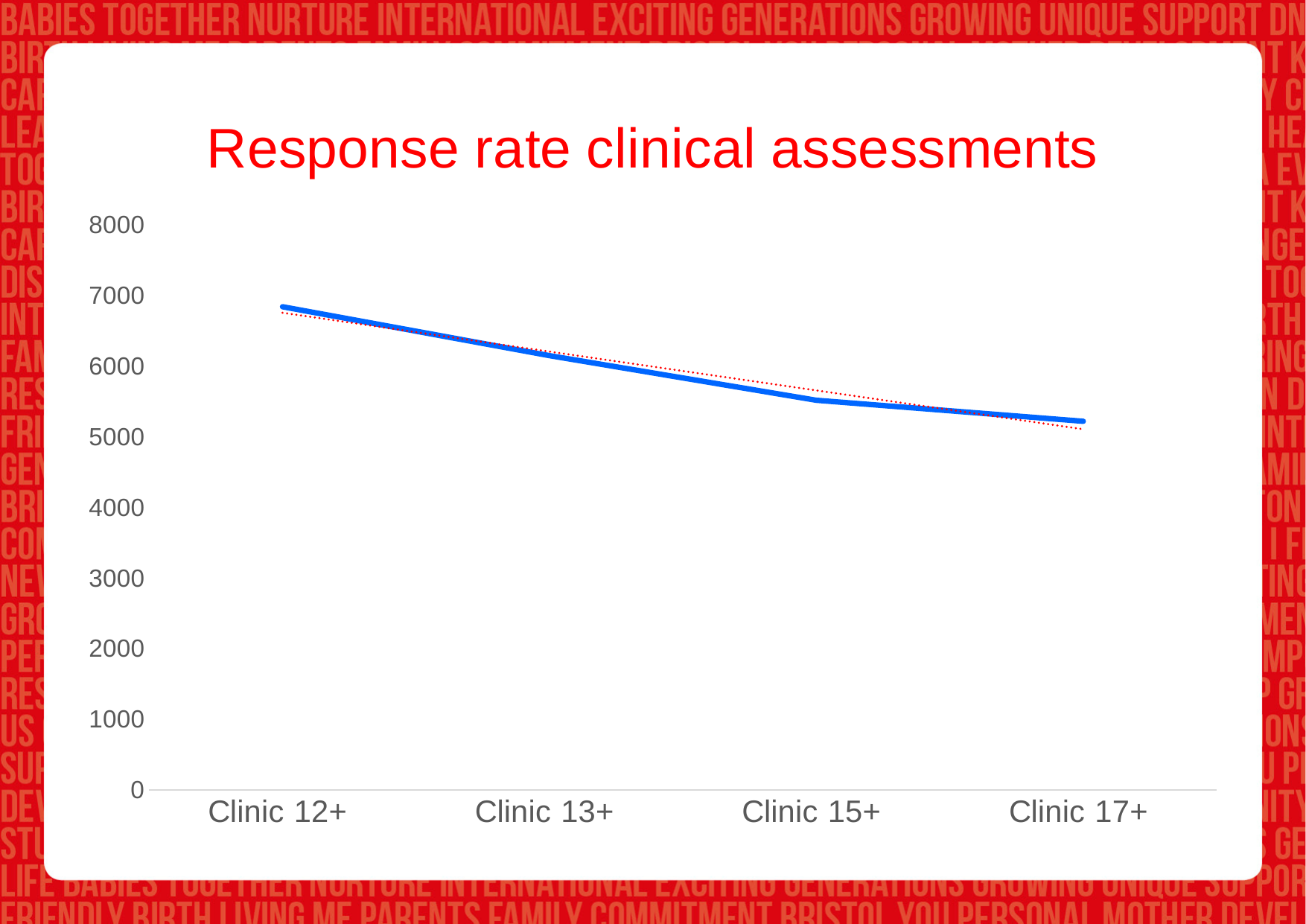
Is the value for Clinic 12+ greater or less than 6000? greater What is the title of the chart? Response rate clinical assessments Which is larger, the value for Clinic 13+ or the value for Clinic 15+? Clinic 13+ Is the value for Clinic 13+ greater or less than 7000? less Is the value for Clinic 17+ greater or less than 6000? less Which clinic has the lowest value? Clinic 17+ Do the values rise or fall from Clinic 12+ to Clinic 17+? fall What is the highest value shown on the y axis? 8000 How many clinics are plotted along the x axis? 4 Which clinic has the highest value? Clinic 12+ What kind of chart is shown on the slide? line chart